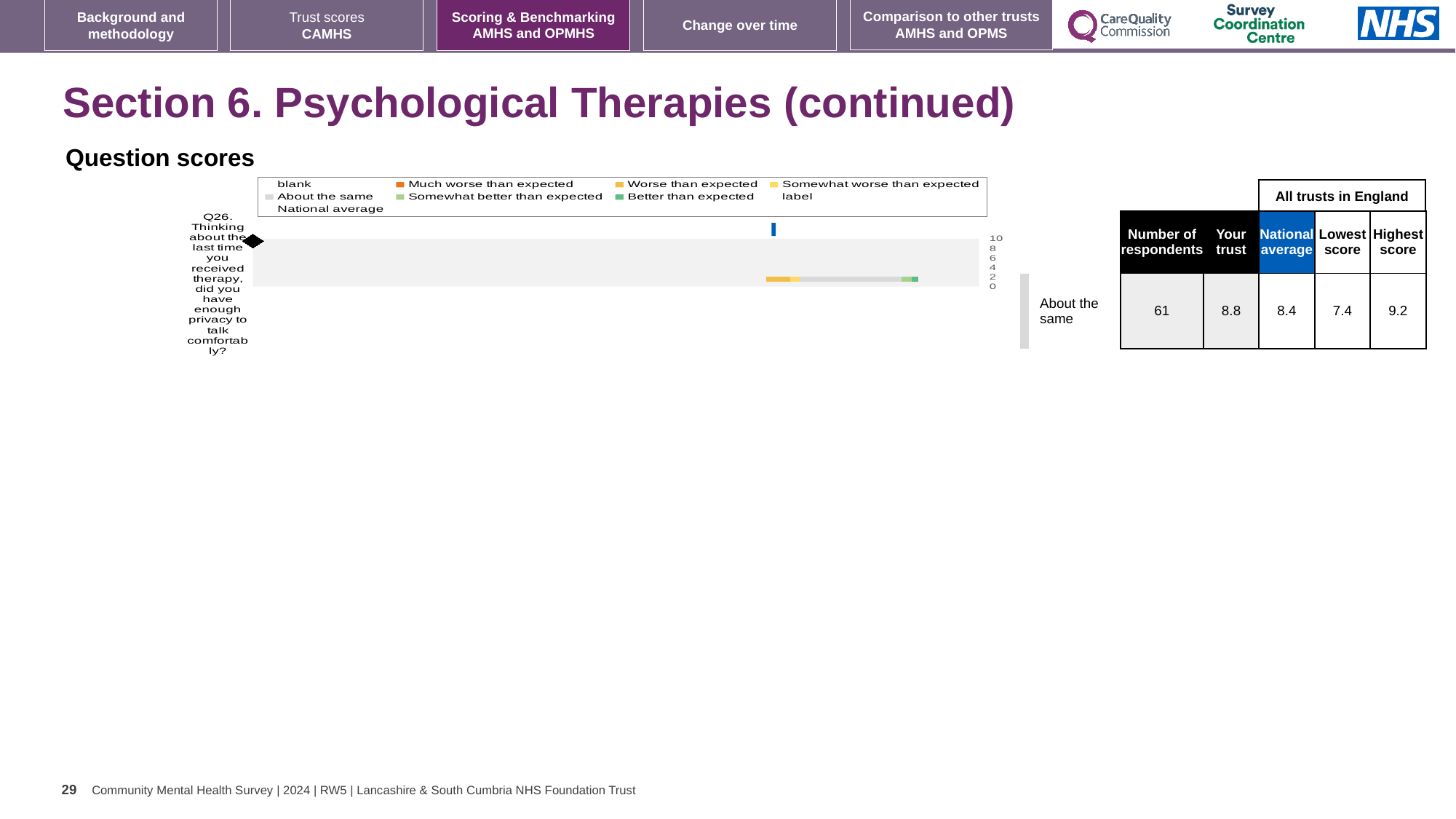
What kind of chart is shown under 'Question scores'? bar chart Which question is plotted in the Question scores chart? Q26. Thinking about the last time you received therapy, did you have enough privacy to talk comfortably? For Q26, what is the difference between the Highest score and the Lowest score among all trusts in England? 1.8 For Q26, which is larger: the 'Your trust' score or the National average? Your trust In the chart legend, which entry is shown in grey? About the same What is the National average for Q26 in the table next to the chart? 8.4 How many questions (categories) are plotted in the Question scores chart? 1 What benchmark category is given for Q26 beside the chart? About the same What is the 'Your trust' score for Q26 in the table next to the chart? 8.8 What is the Highest score among all trusts in England for Q26? 9.2 How many respondents answered Q26 according to the table? 61 What is the Lowest score among all trusts in England for Q26? 7.4